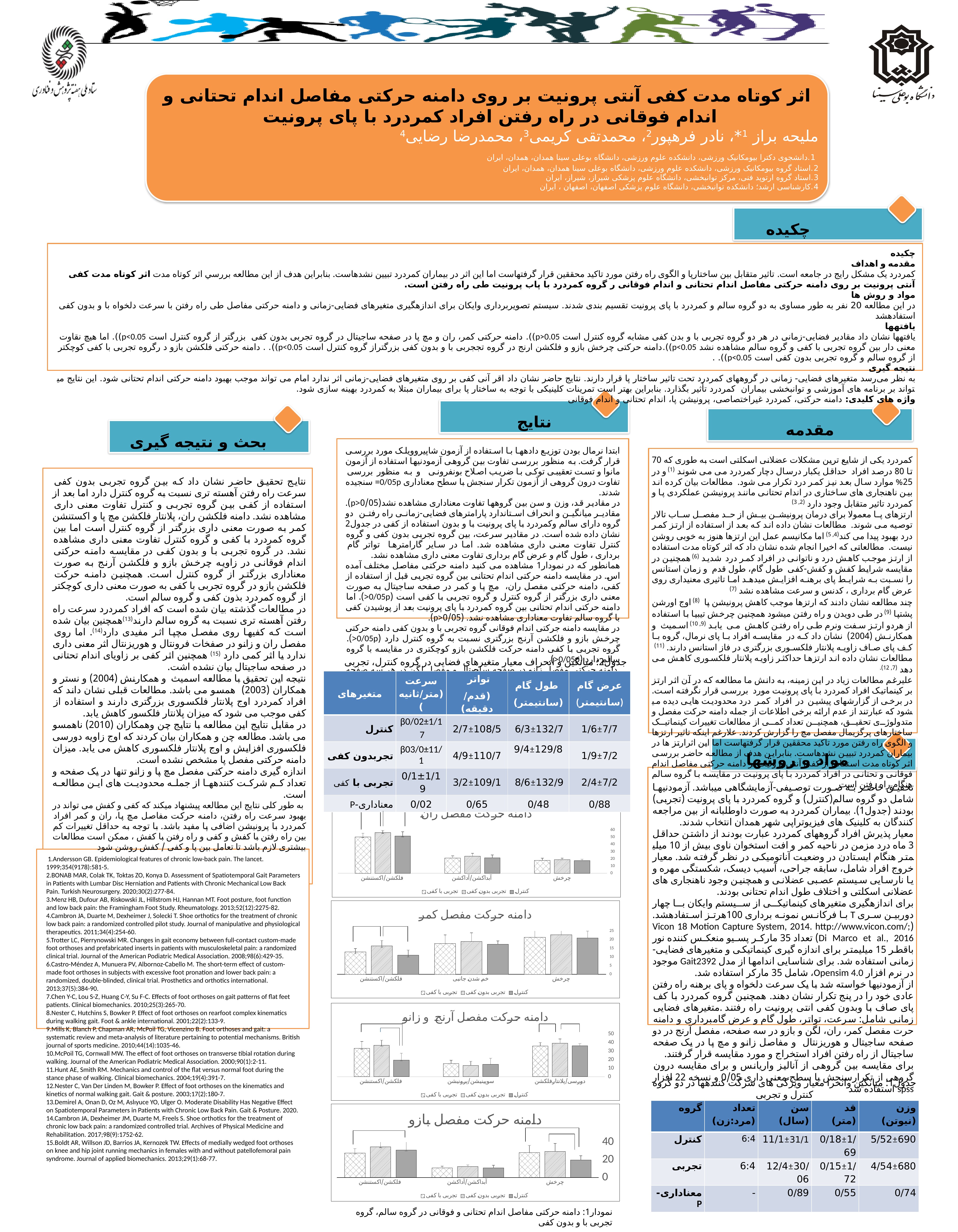
In the "دامنه حرکت مفصل کمر" chart, is the value for کنترل in چرخش greater or less than 15? greater What kind of chart is the "دامنه حرکت مفصل ران" chart? bar chart In the "دامنه حرکت مفصل کمر" chart, which category has the highest values? چرخش How many categories are shown on the x axis of the "دامنه حرکت مفصل بازو" chart? 3 In the "دامنه حرکت مفصل ران" chart, is the value for کنترل in فلکشن/اکستنشن greater or less than 40? greater How many series does the legend of the "دامنه حرکت مفصل کمر" chart list? 3 In the "دامنه حرکت مفصل آرنج و زانو" chart, is the value for کنترل in سوپینیشن/پرونیشن greater or less than 20? less What are the three legend entries of the "دامنه حرکت مفصل بازو" chart? کنترل, تجربی بدون کفی, تجربی با کفی In the "دامنه حرکت مفصل ران" chart, which category has the highest values? فلکشن/اکستنشن In the "دامنه حرکت مفصل بازو" chart, which is larger for کنترل: فلکشن/اکستنشن or آبداکشن/آداکشن? فلکشن/اکستنشن In the "دامنه حرکت مفصل بازو" chart, which category has the lowest values? آبداکشن/آداکشن In the "دامنه حرکت مفصل آرنج و زانو" chart, which category has the lowest values? سوپینیشن/پرونیشن